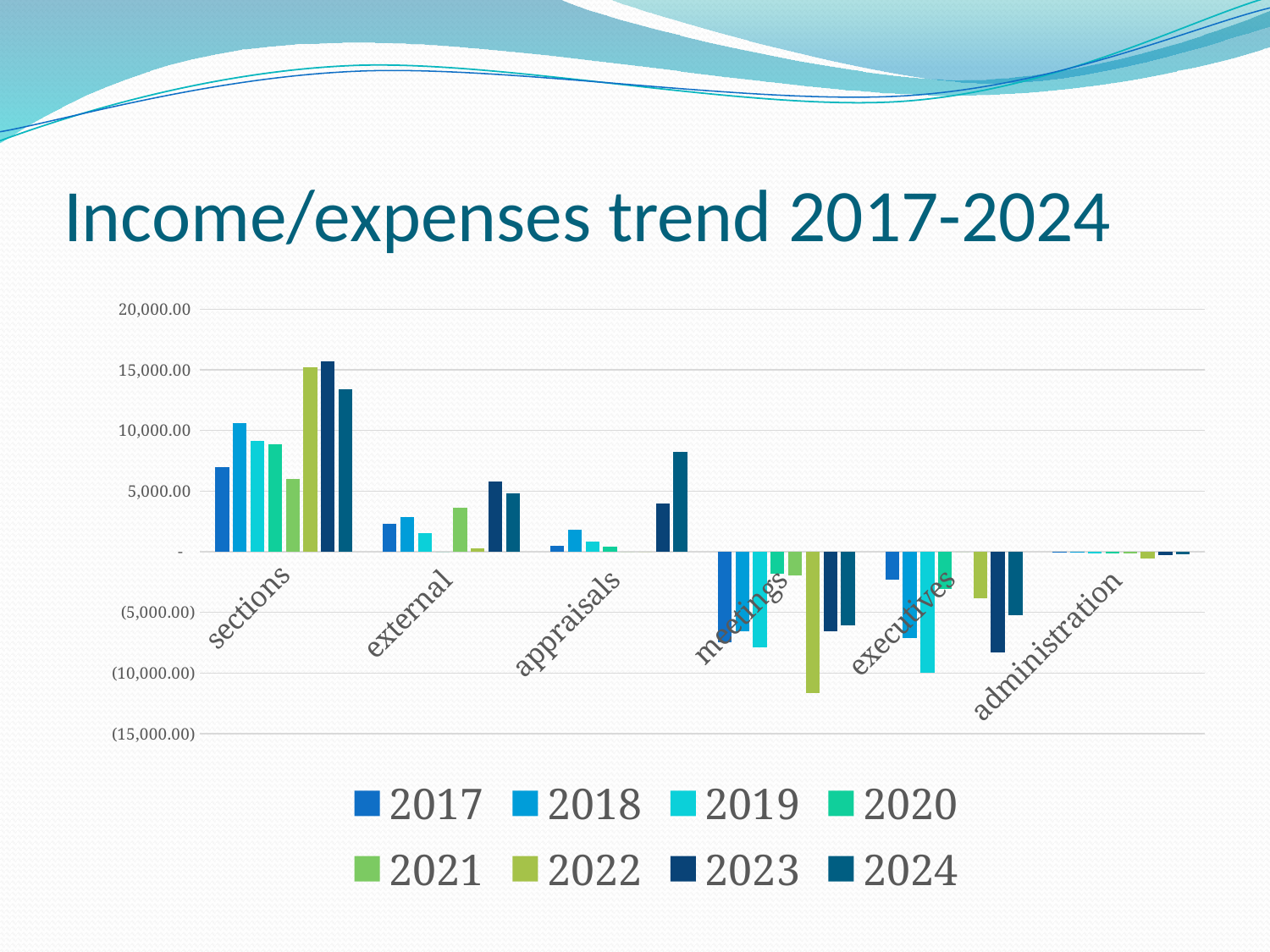
Is the value for meetings in 2022 greater or less than (10,000.00)? less Is the value for appraisals in 2024 greater or less than 5,000.00? greater What is the title of the chart? Income/expenses trend 2017-2024 How many categories are shown on the x axis? 6 For sections, which is larger: the 2017 value or the 2018 value? 2018 What kind of chart is shown on the slide? bar chart Is the value for sections in 2024 greater or less than 10,000.00? greater Which category has the tallest bar on the chart? sections How many series does the legend list? 8 Which category contains the lowest (most negative) bar on the chart? meetings